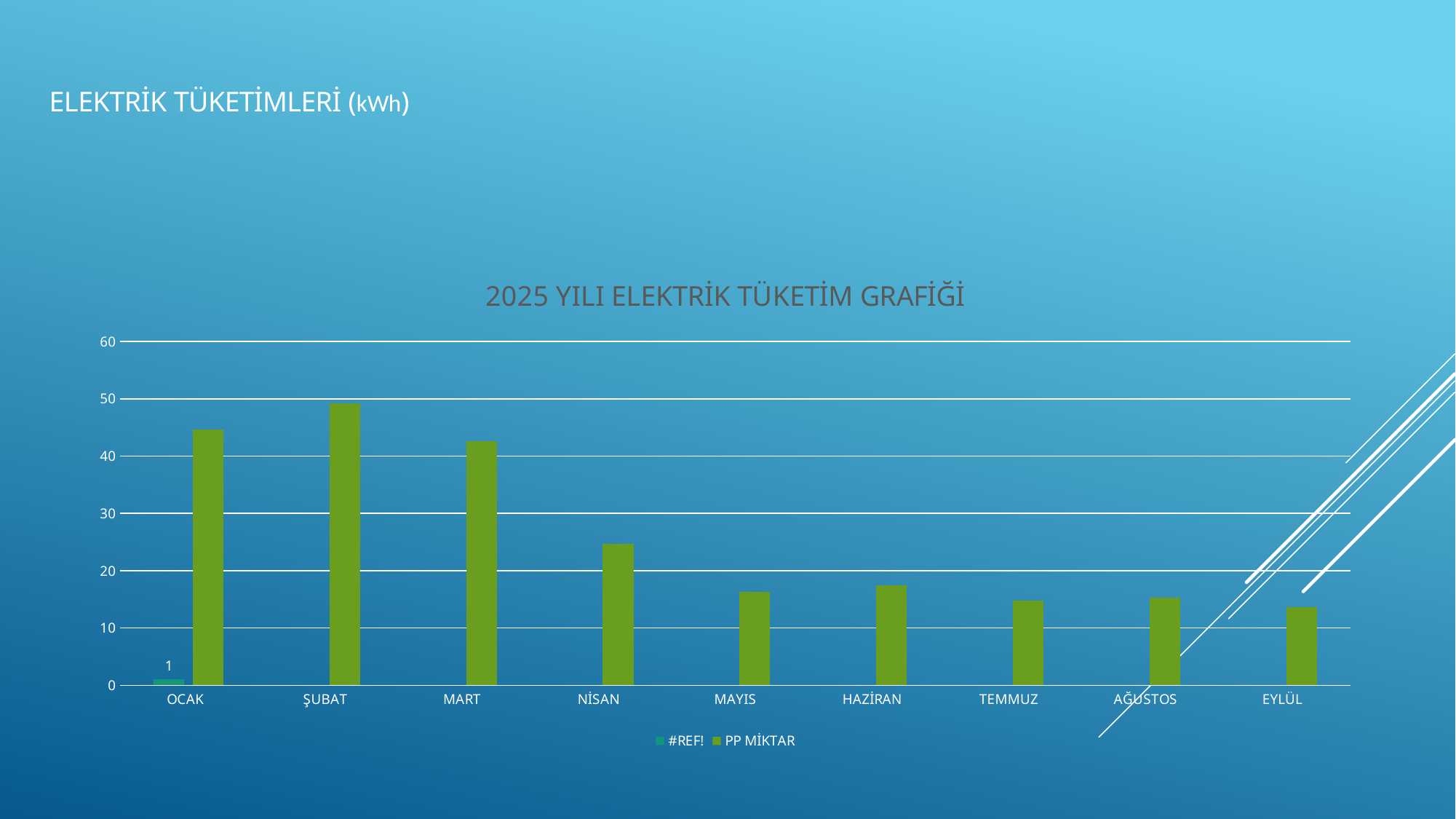
Which has a larger PP MİKTAR value, NİSAN or MAYIS? NİSAN How many months are shown on the x axis? 9 Which month has the highest PP MİKTAR value? ŞUBAT What type of chart is shown on the slide? bar chart What is the title of the chart? 2025 YILI ELEKTRİK TÜKETİM GRAFİĞİ Is the PP MİKTAR value for NİSAN greater or less than 20? greater Is the PP MİKTAR value for MART greater or less than 40? greater How many series does the legend list? 2 Do the PP MİKTAR values generally rise or fall from OCAK to EYLÜL? fall Is the PP MİKTAR value for EYLÜL greater or less than 10? greater What is the data label shown for the #REF! series in OCAK? 1